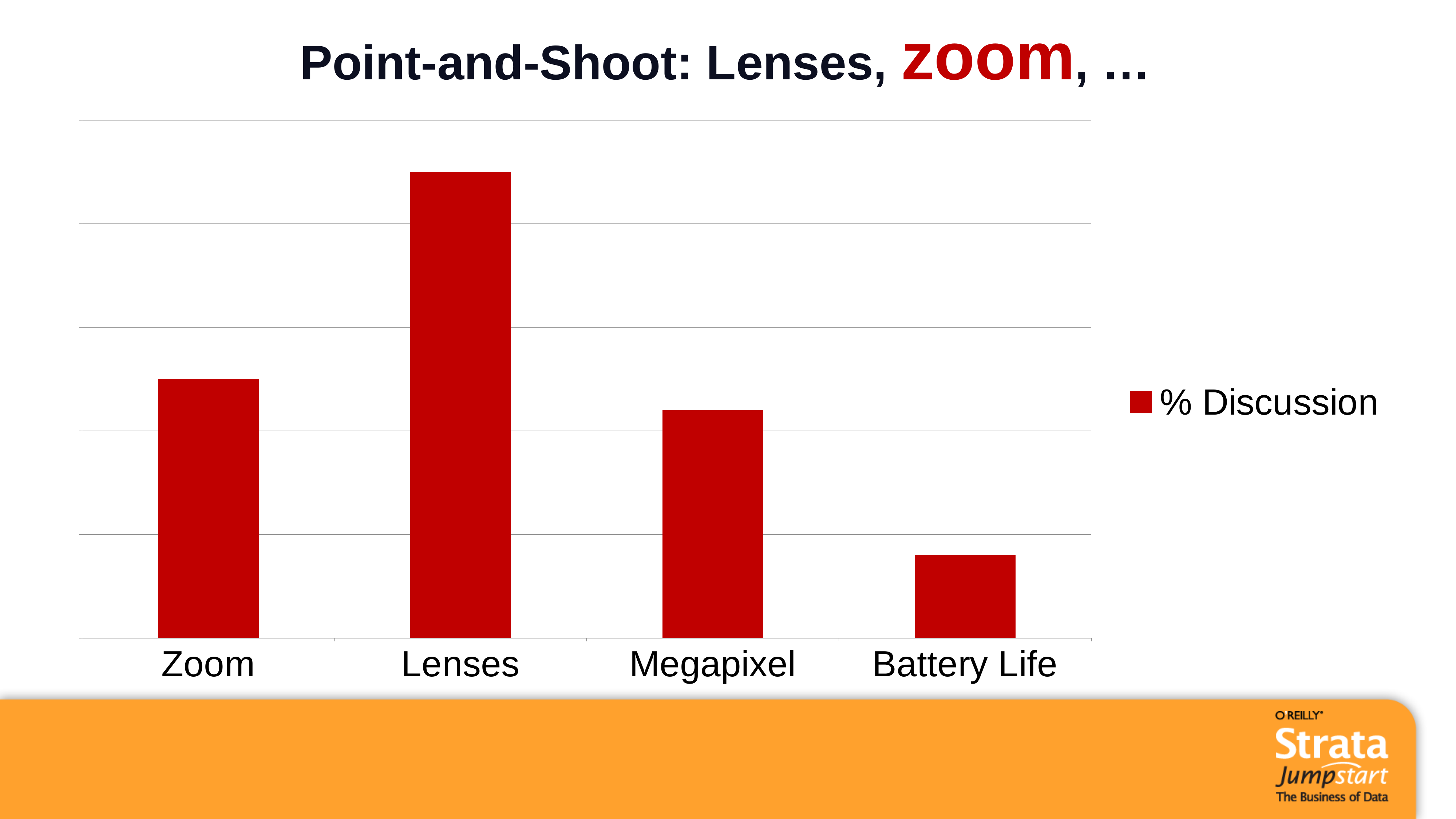
Which category has the highest % Discussion value? Lenses How many series does the legend list? 1 Which category has the lowest % Discussion value? Battery Life How many categories are shown on the x axis of the chart? 4 What series name is shown in the chart legend? % Discussion Which has a larger % Discussion value, Megapixel or Battery Life? Megapixel Which has a larger % Discussion value, Zoom or Megapixel? Zoom Which has a larger % Discussion value, Lenses or Zoom? Lenses Does the value rise or fall from Zoom to Lenses? Rise What kind of chart is shown on the slide? Bar chart What is the title of the slide containing the chart? Point-and-Shoot: Lenses, zoom, … Does the value rise or fall from Megapixel to Battery Life? Fall